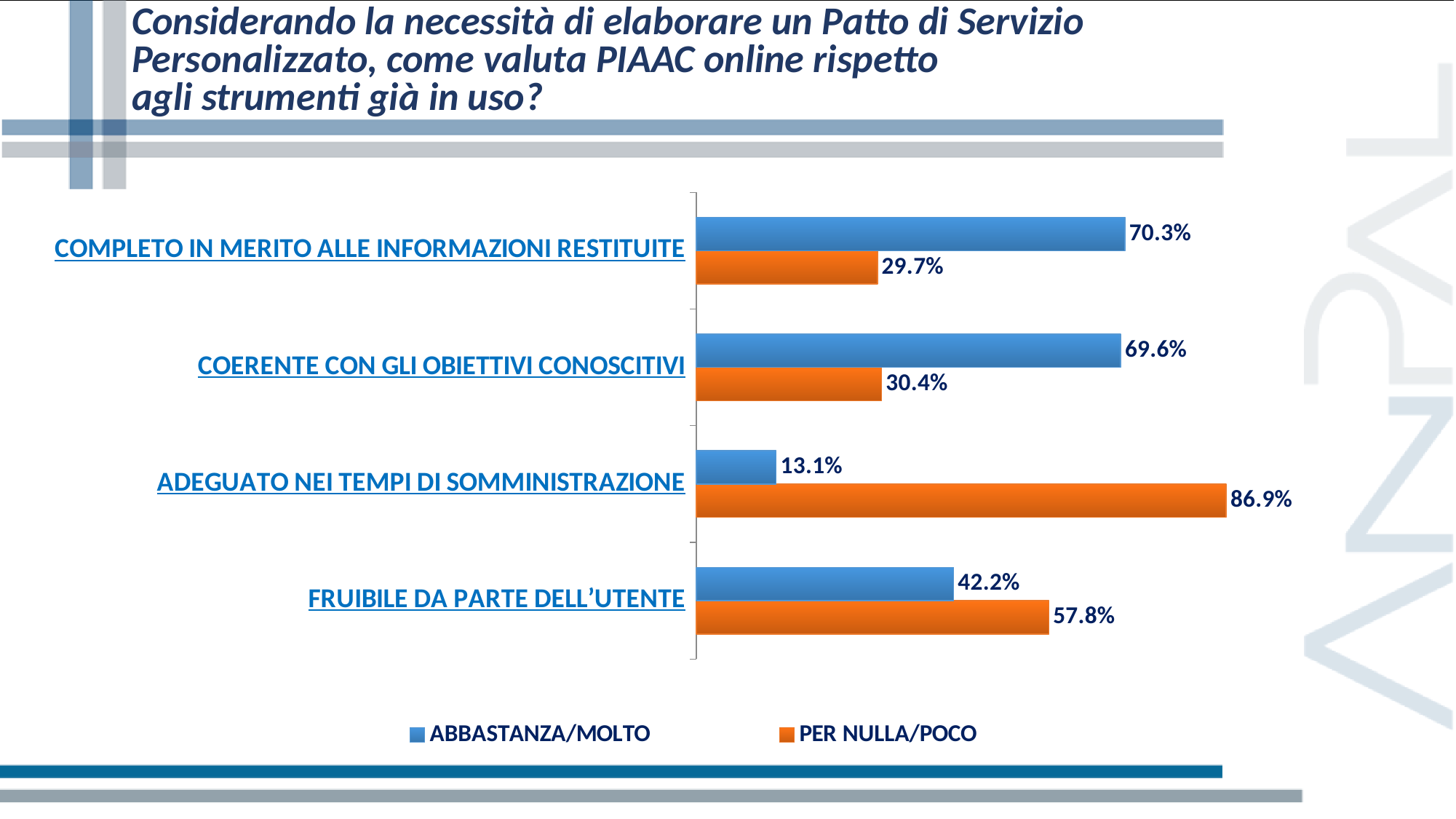
For COERENTE CON GLI OBIETTIVI CONOSCITIVI, which is larger: ABBASTANZA/MOLTO or PER NULLA/POCO? ABBASTANZA/MOLTO What is the ABBASTANZA/MOLTO value for COMPLETO IN MERITO ALLE INFORMAZIONI RESTITUITE? 70.3% What kind of chart is shown on the slide? Bar chart What is the ABBASTANZA/MOLTO value for COERENTE CON GLI OBIETTIVI CONOSCITIVI? 69.6% Which category has the lowest ABBASTANZA/MOLTO value? ADEGUATO NEI TEMPI DI SOMMINISTRAZIONE What is the PER NULLA/POCO value for ADEGUATO NEI TEMPI DI SOMMINISTRAZIONE? 86.9% How many series does the legend list? 2 Which colour represents the PER NULLA/POCO series? Orange What is the PER NULLA/POCO value for FRUIBILE DA PARTE DELL'UTENTE? 57.8% What is the difference between the PER NULLA/POCO and ABBASTANZA/MOLTO values for FRUIBILE DA PARTE DELL'UTENTE? 15.6% Which category has the highest PER NULLA/POCO value? ADEGUATO NEI TEMPI DI SOMMINISTRAZIONE How many categories are shown in the chart? 4